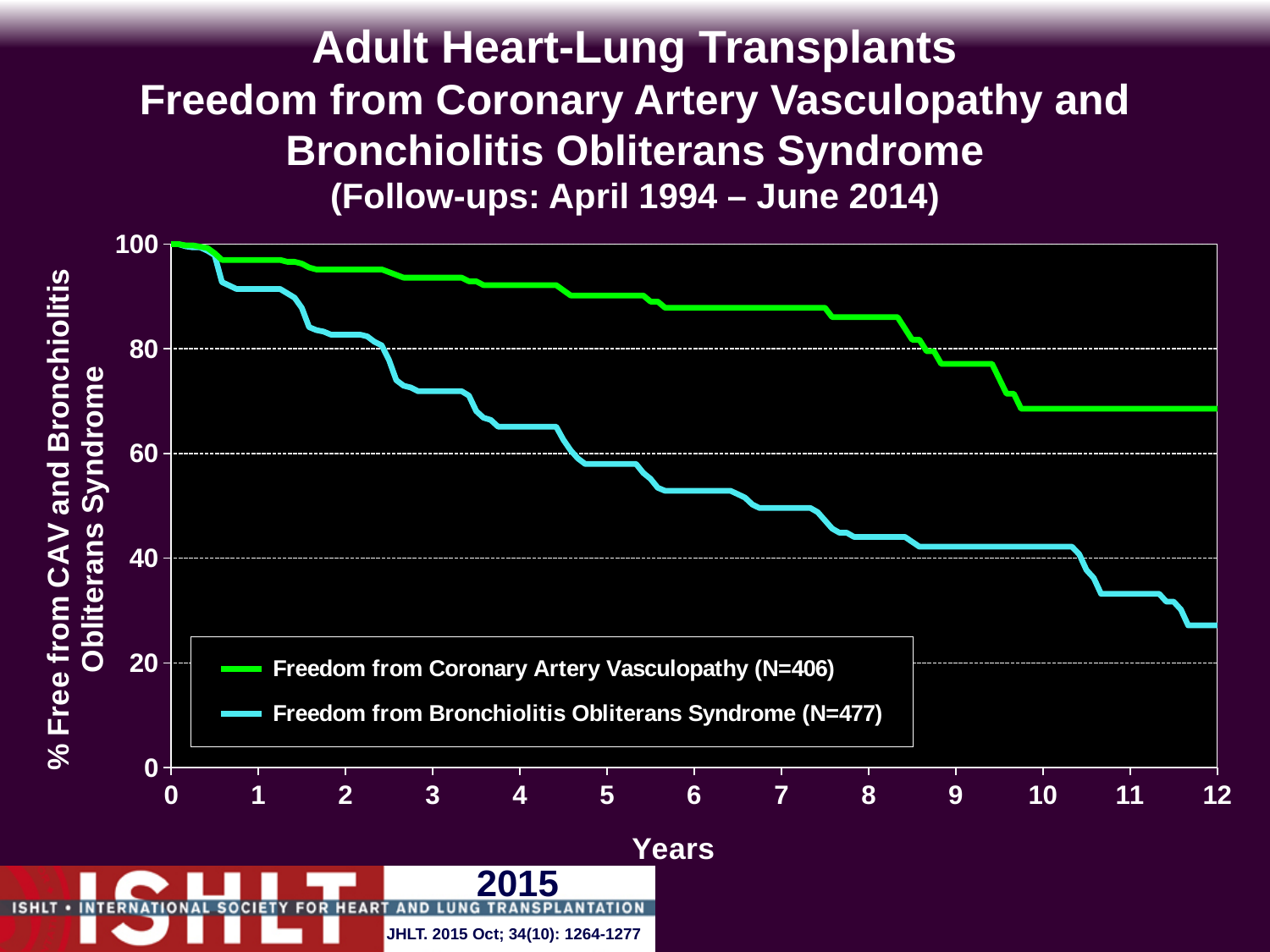
Is the value of the Freedom from Bronchiolitis Obliterans Syndrome line at 3 years greater or less than 60? greater What is the N value given in the legend for Freedom from Coronary Artery Vasculopathy? N=406 At 6 years, which line is higher: Freedom from Coronary Artery Vasculopathy or Freedom from Bronchiolitis Obliterans Syndrome? Freedom from Coronary Artery Vasculopathy Is the value of the Freedom from Bronchiolitis Obliterans Syndrome line at 12 years greater or less than 20? greater What is the N value given in the legend for Freedom from Bronchiolitis Obliterans Syndrome? N=477 Is the value of the Freedom from Coronary Artery Vasculopathy line at 6 years greater or less than 80? greater What is the label of the x axis? Years How many series does the legend list? 2 Do the values of the Freedom from Bronchiolitis Obliterans Syndrome line rise or fall as years increase? fall What kind of chart is shown on the slide? line chart